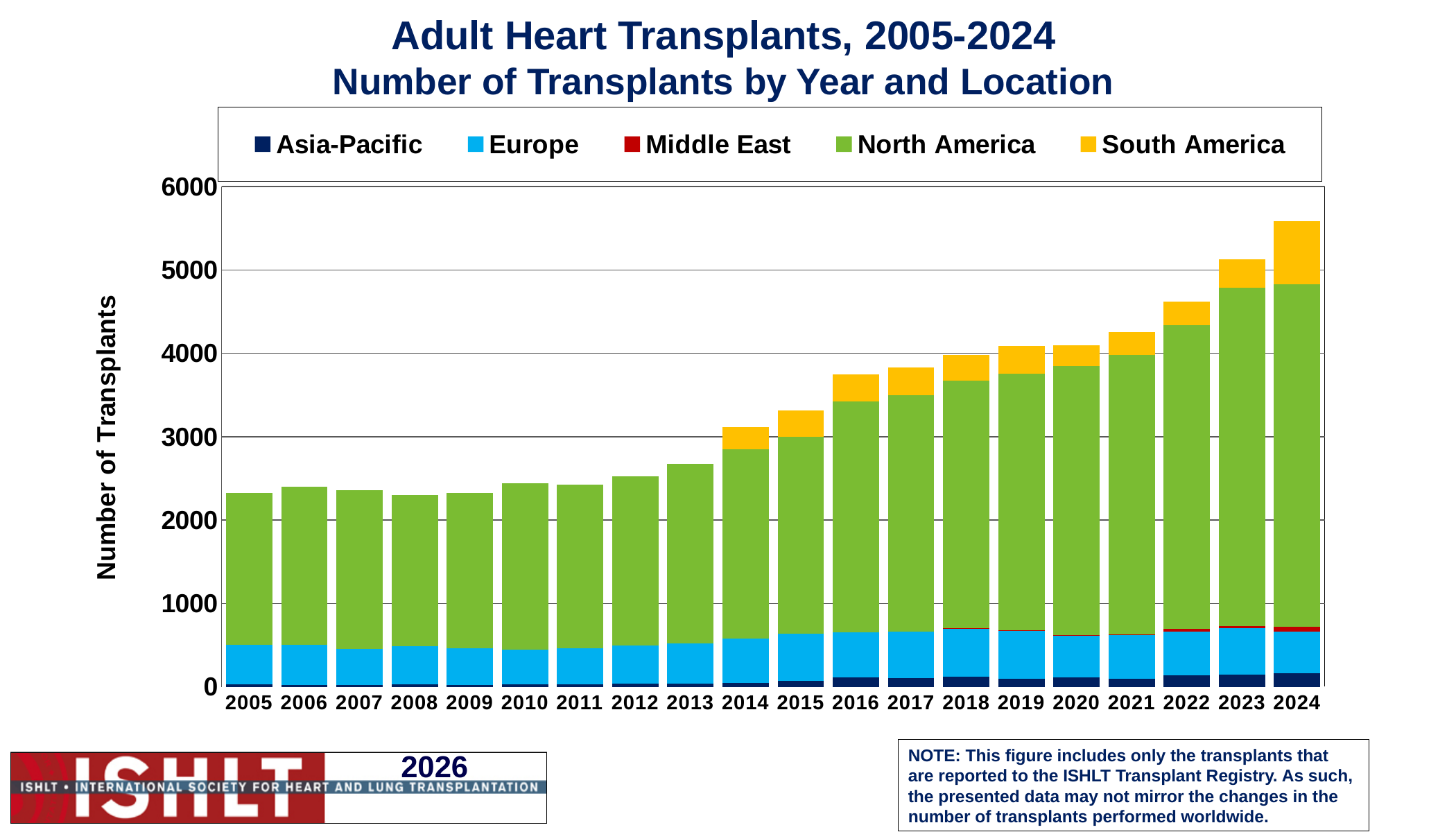
Is the total number of transplants in 2013 greater or less than 3000? less Is the total number of transplants in 2024 greater or less than 5000? greater Which year has the larger total number of transplants, 2013 or 2014? 2014 Is the total number of transplants in 2016 greater or less than 3000? greater Which location accounts for the largest portion of each bar? North America How many series does the legend list? 5 Which year has the highest total number of transplants? 2024 What kind of chart is shown on the slide? Stacked bar chart Do the total numbers of transplants generally rise or fall from 2005 to 2024? Rise What colour represents South America in the chart? Yellow How many years are shown along the x axis? 20